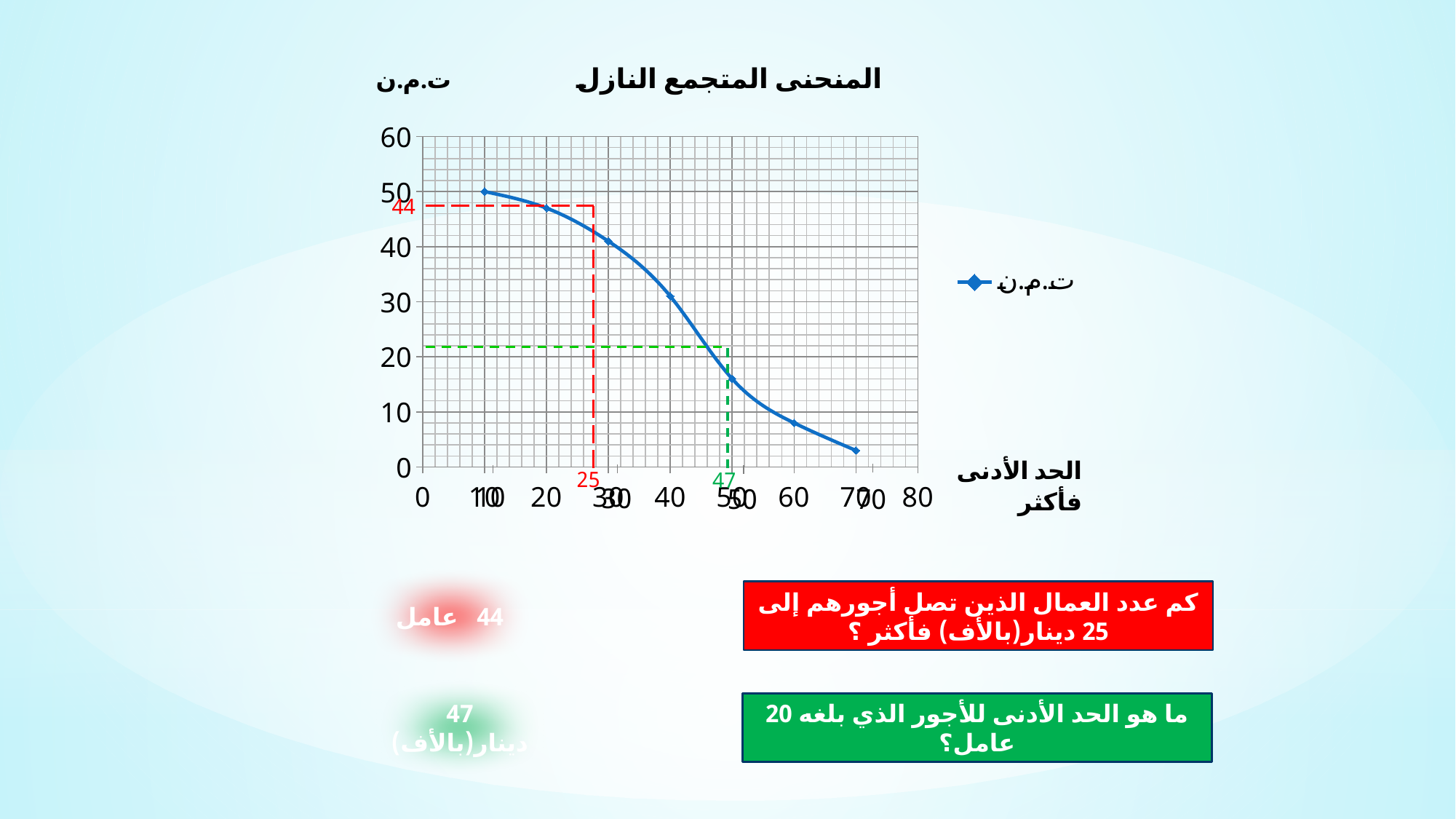
How many data points are marked on the curve? 7 Is the value of the curve at x = 60 greater or less than 20? less Do the values of the curve rise or fall as the x axis increases? fall According to the red dashed lines, what y value corresponds to x = 25? 44 How many series does the legend list? 1 What kind of chart is shown on the slide? line chart Which x value has the highest point on the curve, 10 or 70? 10 Is the value of the curve at x = 70 greater or less than 10? less What is the title of the chart? المنحنى المتجمع النازل What is the legend entry for the plotted series? ت.م.ن Is the value of the curve at x = 10 greater or less than 40? greater